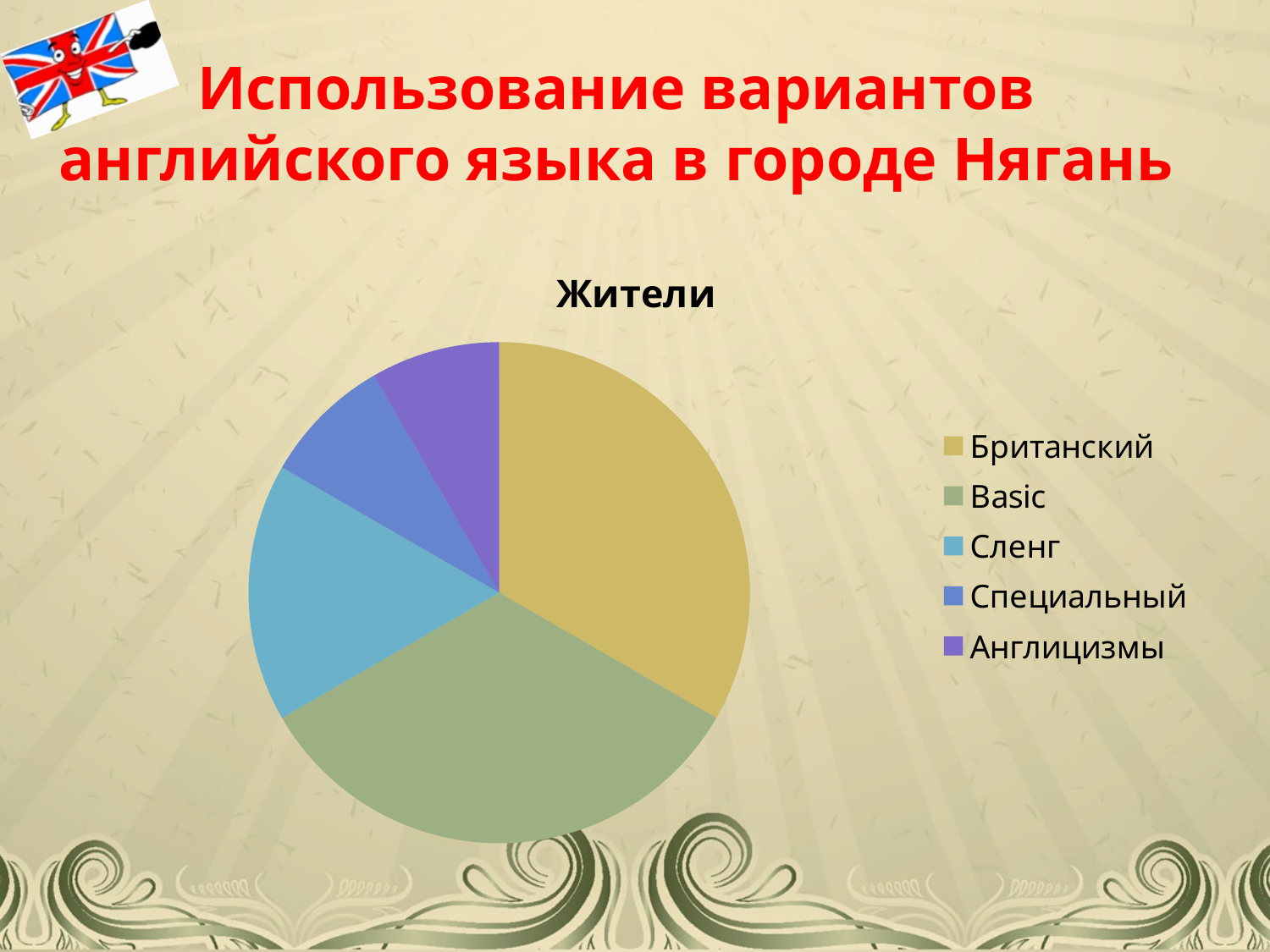
Which slice is larger, Basic or Специальный? Basic How many categories does the pie chart show? 5 Which slice is larger, Британский or Англицизмы? Британский What is the title of the pie chart? Жители What kind of chart is shown on the slide? pie chart Which slice is larger, Basic or Сленг? Basic Which colour represents the Basic category in the pie chart? green How many entries does the legend of the pie chart list? 5